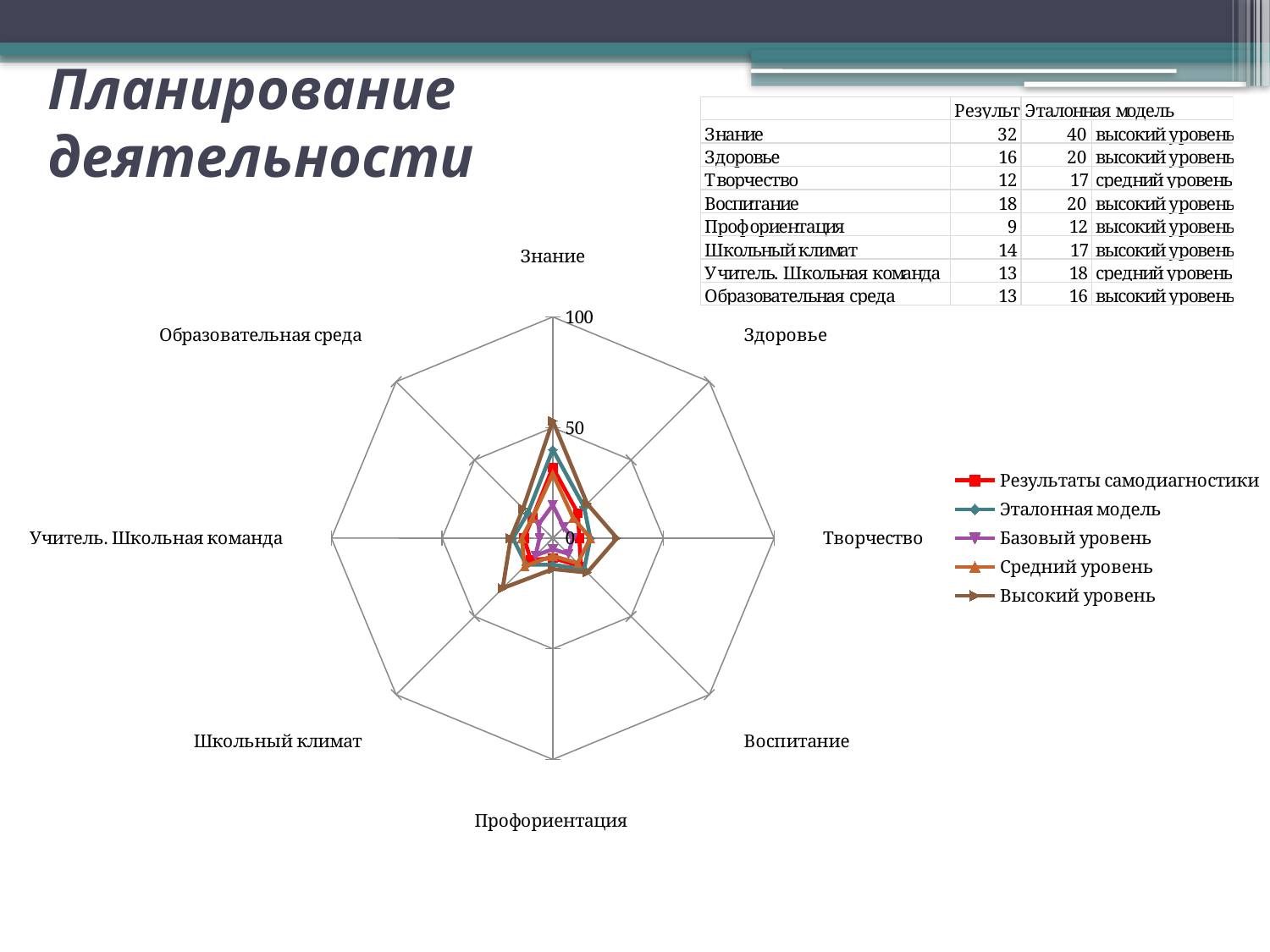
What is the difference between the Эталонная модель and Результаты values for Знание in the table? 8 Which category is at the top of the radar chart? Знание What is the highest value shown on the radial axis of the radar chart? 100 What kind of chart is shown on the slide? Radar chart According to the table on the slide, what is the Эталонная модель value for Творчество? 17 Which category has the highest value for the Результаты самодиагностики series? Знание How many categories (axes) does the radar chart have? 8 According to the table on the slide, what is the Результаты value for Знание? 32 Is the value for Знание in the Результаты самодиагностики series greater or less than 50 on the radar chart? less Which category has the lowest Результаты value in the table? Профориентация For the Результаты самодиагностики series, which is larger: Знание or Здоровье? Знание How many series does the legend of the radar chart list? 5